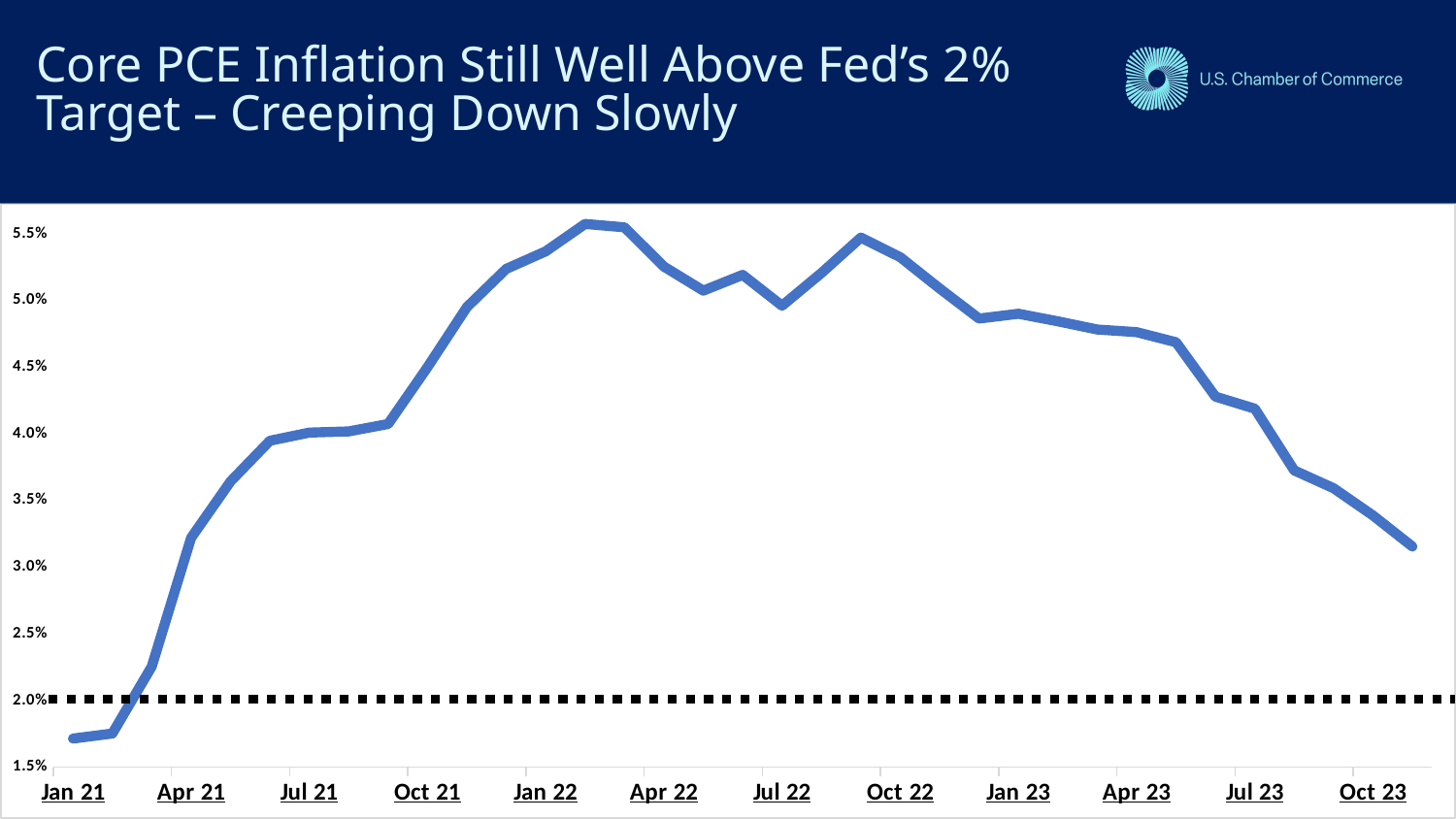
Is the value for Oct 23 greater or less than 3.5%? less How many date labels are shown along the x axis? 12 Is the value for Jan 22 greater or less than 5.0%? greater Is the value for Jul 23 greater or less than 4.5%? less Do the values rise or fall between Jan 21 and Jan 22? rise Do the values rise or fall between Oct 22 and Oct 23? fall What is the title of the chart on the slide? Core PCE Inflation Still Well Above Fed's 2% Target – Creeping Down Slowly What kind of chart is shown on the slide? line chart Which is larger, the value for Jan 22 or the value for Jan 23? Jan 22 Which labelled date on the x axis has the lowest value? Jan 21 At what level is the horizontal dashed line drawn on the chart? 2.0%